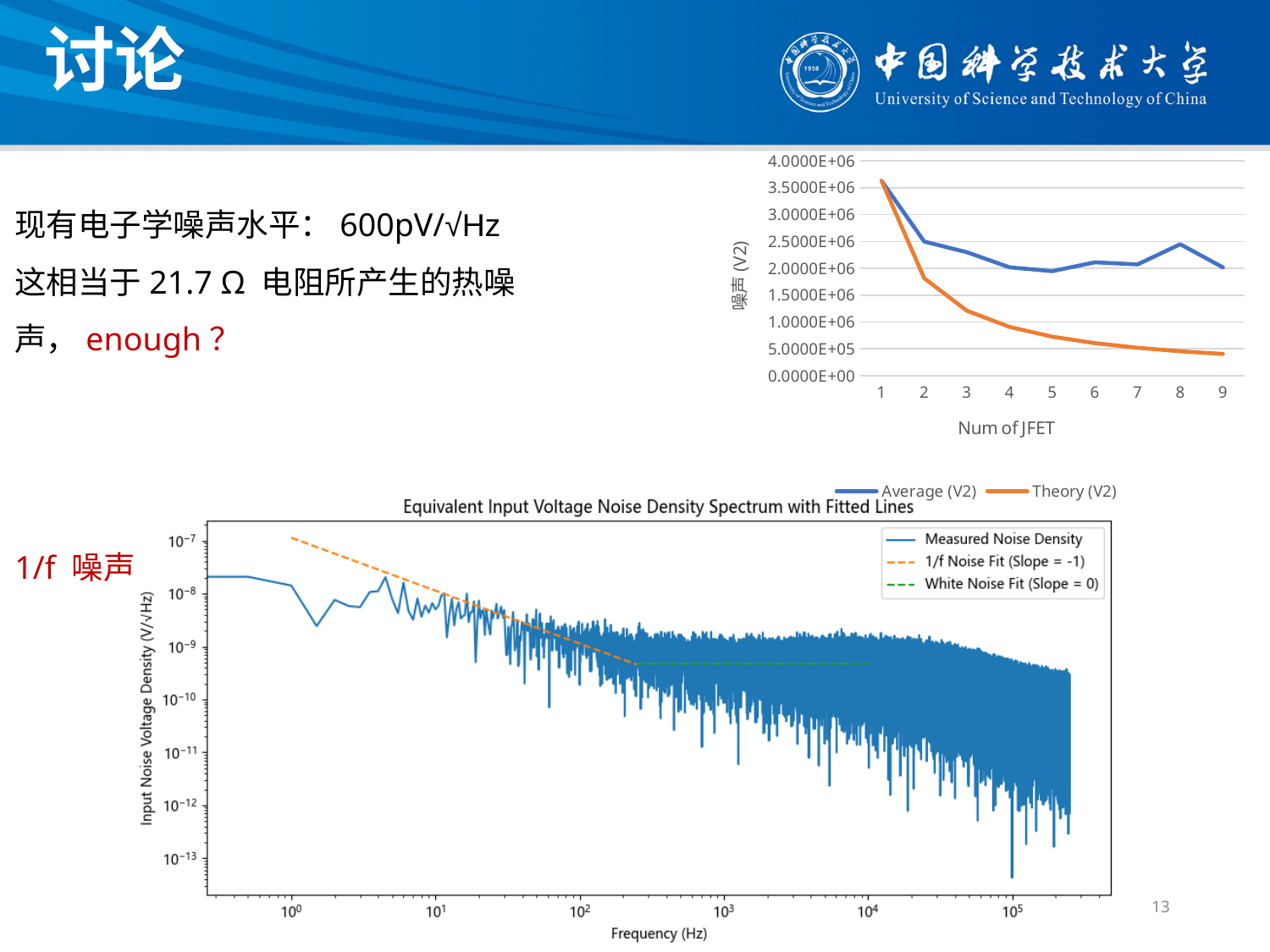
In the top-right chart, at which Num of JFET is the Theory (V2) series lowest? 9 In the top-right chart (噪声 (V2) vs Num of JFET), how many series does the legend list? 2 In the top-right chart, does the Theory (V2) series rise or fall as Num of JFET increases? fall In the bottom chart (Equivalent Input Voltage Noise Density Spectrum), what slope does the legend give for the 1/f Noise Fit? -1 In the top-right chart, is the Average (V2) value at Num of JFET = 1 greater or less than 3.0000E+06? greater What is the title of the bottom chart? Equivalent Input Voltage Noise Density Spectrum with Fitted Lines In the bottom chart (Equivalent Input Voltage Noise Density Spectrum), how many entries does the legend list? 3 What kind of chart is the top-right chart (噪声 (V2) vs Num of JFET)? line chart In the top-right chart, is the Theory (V2) value at Num of JFET = 9 greater or less than 1.0000E+06? less In the top-right chart (噪声 (V2) vs Num of JFET), how many JFET numbers are plotted along the x axis? 9 In the top-right chart, at Num of JFET = 5, which series has the larger value, Average (V2) or Theory (V2)? Average (V2) In the top-right chart (噪声 (V2) vs Num of JFET), what are the two series named in the legend? Average (V2) and Theory (V2)